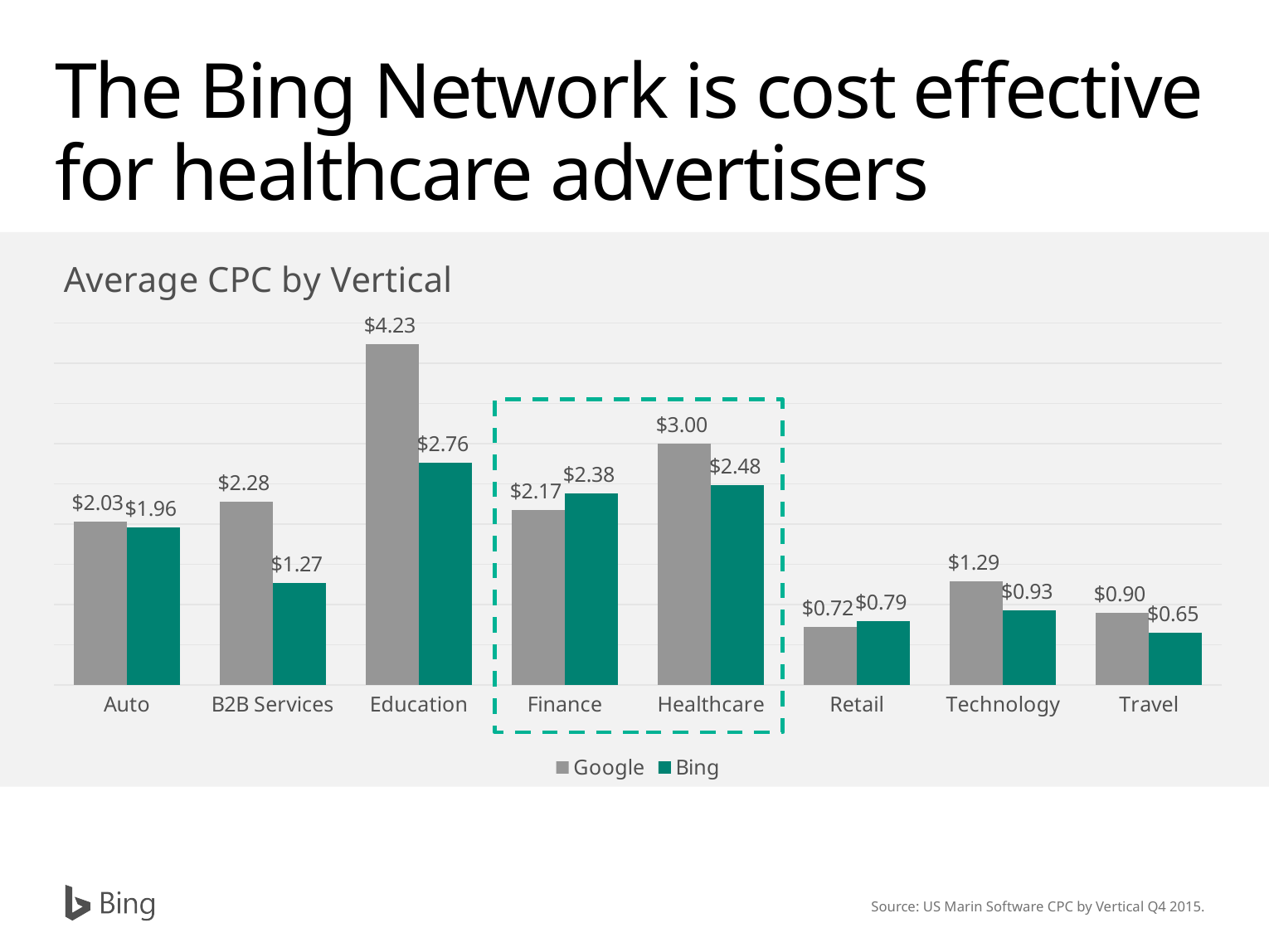
For Finance, which is higher, the Google or the Bing average CPC? Bing Which vertical has the lowest Bing average CPC? Travel Which vertical has the highest Google average CPC? Education How many series does the chart legend list? 2 What is the Bing average CPC for B2B Services? $1.27 What is the difference between the Google and Bing average CPC for Education? $1.47 What type of chart is shown on the slide? Bar chart What is the Google average CPC for Education? $4.23 What is the difference between the Google and Bing average CPC for Healthcare? $0.52 What is the Bing average CPC for Healthcare? $2.48 For Technology, which is higher, the Google or the Bing average CPC? Google How many verticals are shown on the x axis of the chart? 8